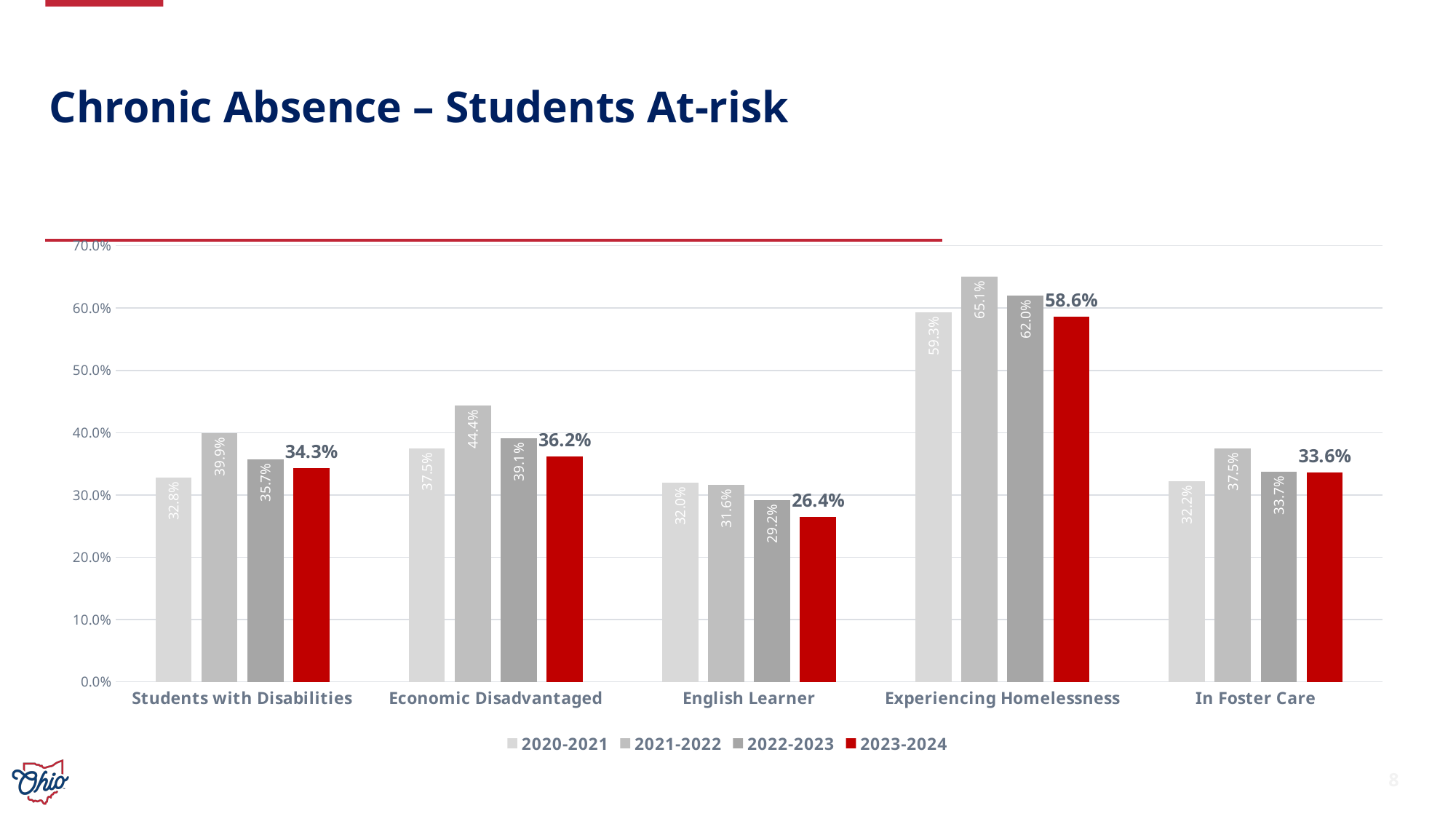
What type of chart is shown on the slide? Bar chart What is the difference between the 2021-2022 and 2023-2024 values for Economic Disadvantaged? 8.2% Which category has the highest 2023-2024 value? Experiencing Homelessness Which category has the lowest 2023-2024 value? English Learner What is the 2022-2023 value for English Learner? 29.2% How many series does the legend list? 4 What is the 2020-2021 value for In Foster Care? 32.2% Which is larger for Experiencing Homelessness: the 2020-2021 value or the 2022-2023 value? 2022-2023 How many student categories are shown on the x axis? 5 What is the 2023-2024 chronic absence rate for Students with Disabilities? 34.3% Is the 2021-2022 value for Economic Disadvantaged greater or less than 40.0%? greater What is the 2021-2022 value for Experiencing Homelessness? 65.1%